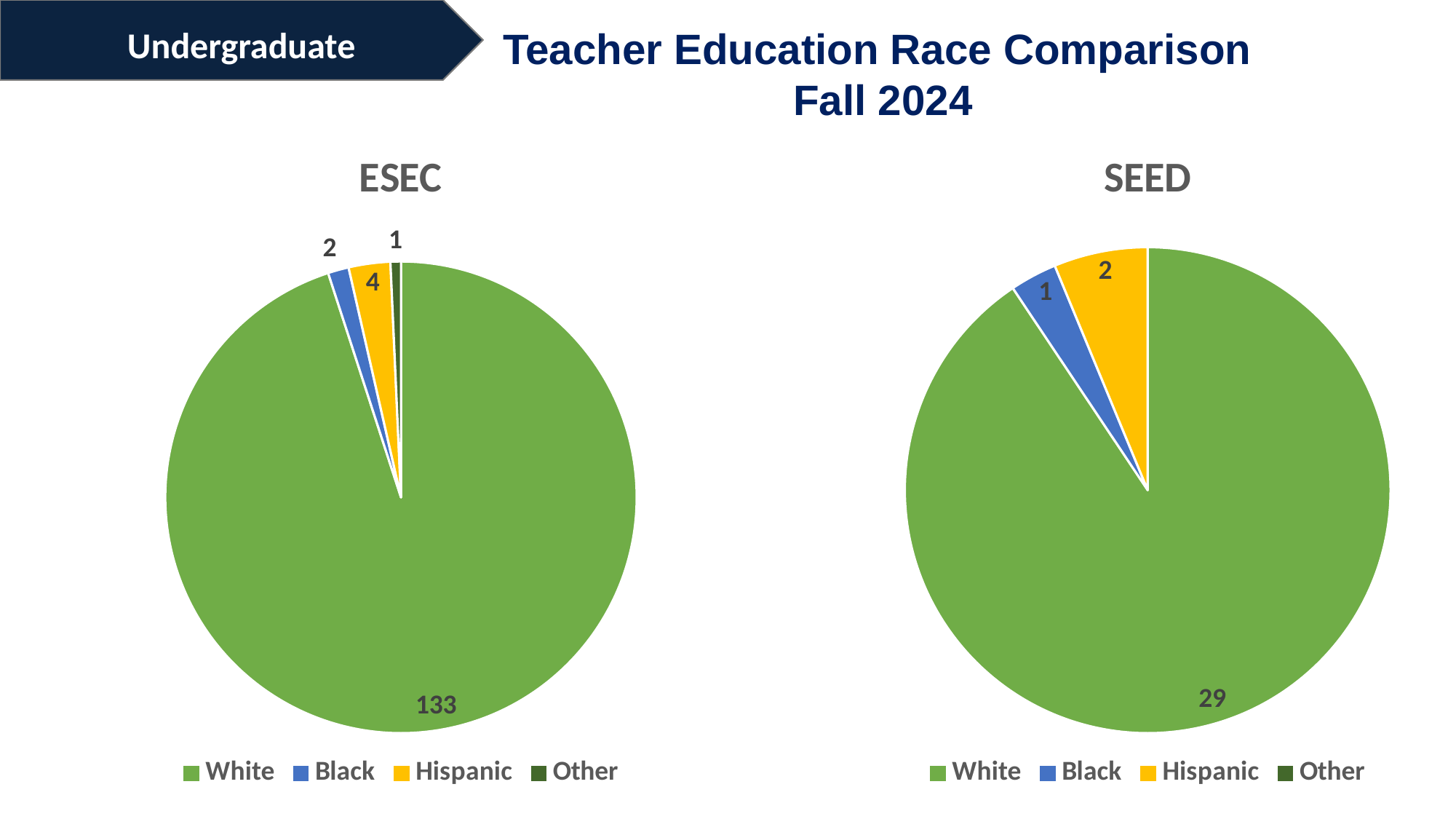
How many categories does the legend of the ESEC chart list? 4 In the SEED chart, which is larger, Hispanic or Black? Hispanic In the SEED chart, what is the value for White? 29 In the ESEC chart, what is the value for White? 133 In the ESEC chart, which category has the largest slice? White In the ESEC chart, which category has the smallest slice? Other What kind of chart is the SEED chart? Pie chart In the ESEC chart, what is the value for Black? 2 In the ESEC chart, what is the value for Hispanic? 4 In the ESEC chart, what share of the total does the White slice represent? 95% In the ESEC chart, what is the difference between the White and Hispanic values? 129 In the SEED chart, what is the value for Hispanic? 2